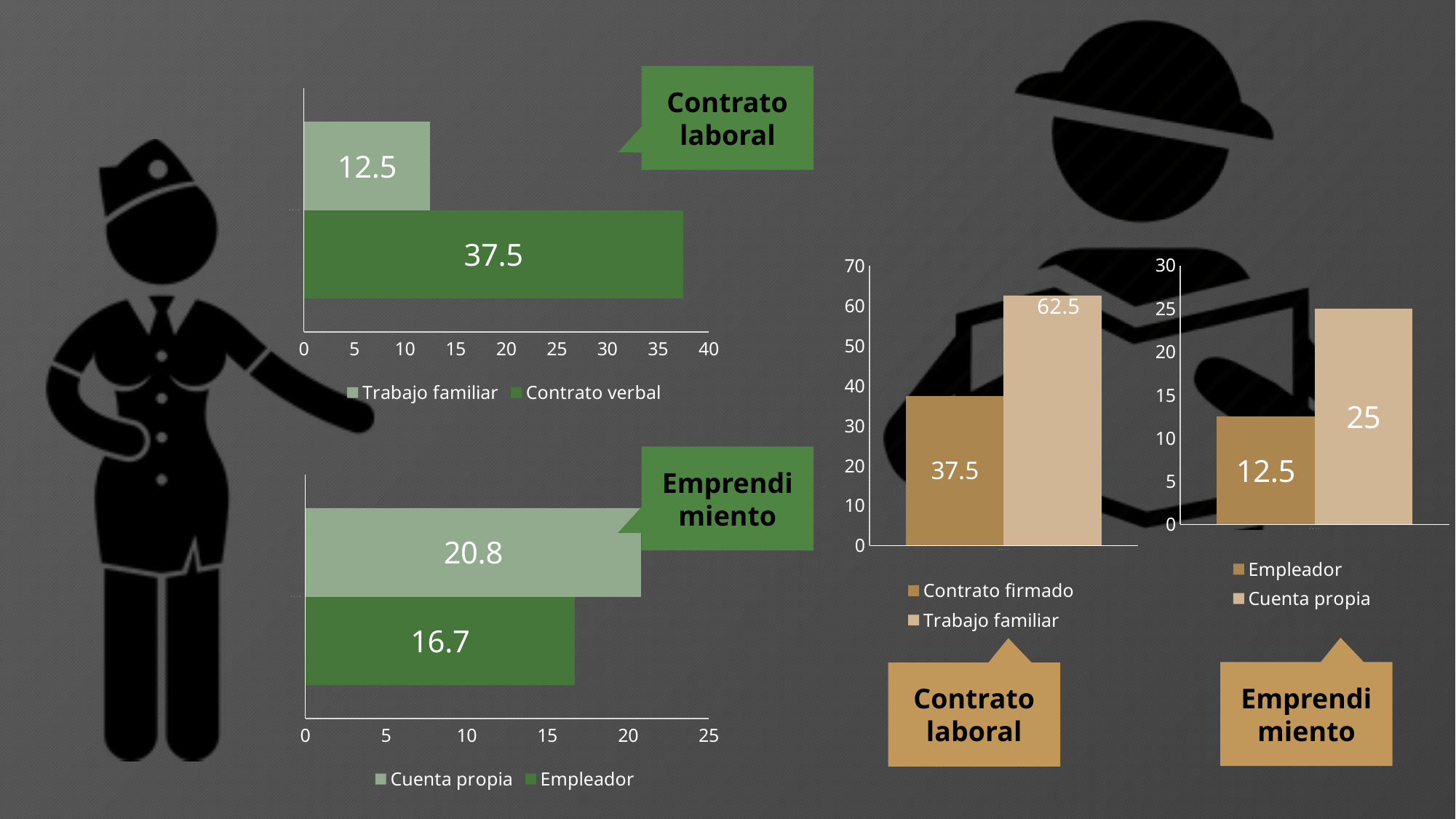
In the vertical bar chart on the right titled 'Contrato laboral', what is the value for Trabajo familiar? 62.5 In the far-right vertical bar chart titled 'Emprendimiento', is Cuenta propia or Empleador larger? Cuenta propia In the top-left horizontal bar chart titled 'Contrato laboral', what is the value for Trabajo familiar? 12.5 In the top-left horizontal bar chart titled 'Contrato laboral', what is the value for Contrato verbal? 37.5 In the vertical bar chart on the right titled 'Contrato laboral', what is the difference between Trabajo familiar and Contrato firmado? 25 In the bottom-left horizontal bar chart titled 'Emprendimiento', what is the difference between Cuenta propia and Empleador? 4.1 In the top-left horizontal bar chart titled 'Contrato laboral', what is the difference between Contrato verbal and Trabajo familiar? 25 In the far-right vertical bar chart titled 'Emprendimiento', what is the value for Empleador? 12.5 In the vertical bar chart on the right titled 'Contrato laboral', which series has the higher value? Trabajo familiar In the bottom-left horizontal bar chart titled 'Emprendimiento', what is the value for Cuenta propia? 20.8 How many series does the legend of the far-right vertical bar chart titled 'Emprendimiento' list? 2 In the bottom-left horizontal bar chart titled 'Emprendimiento', which series has the lower value? Empleador